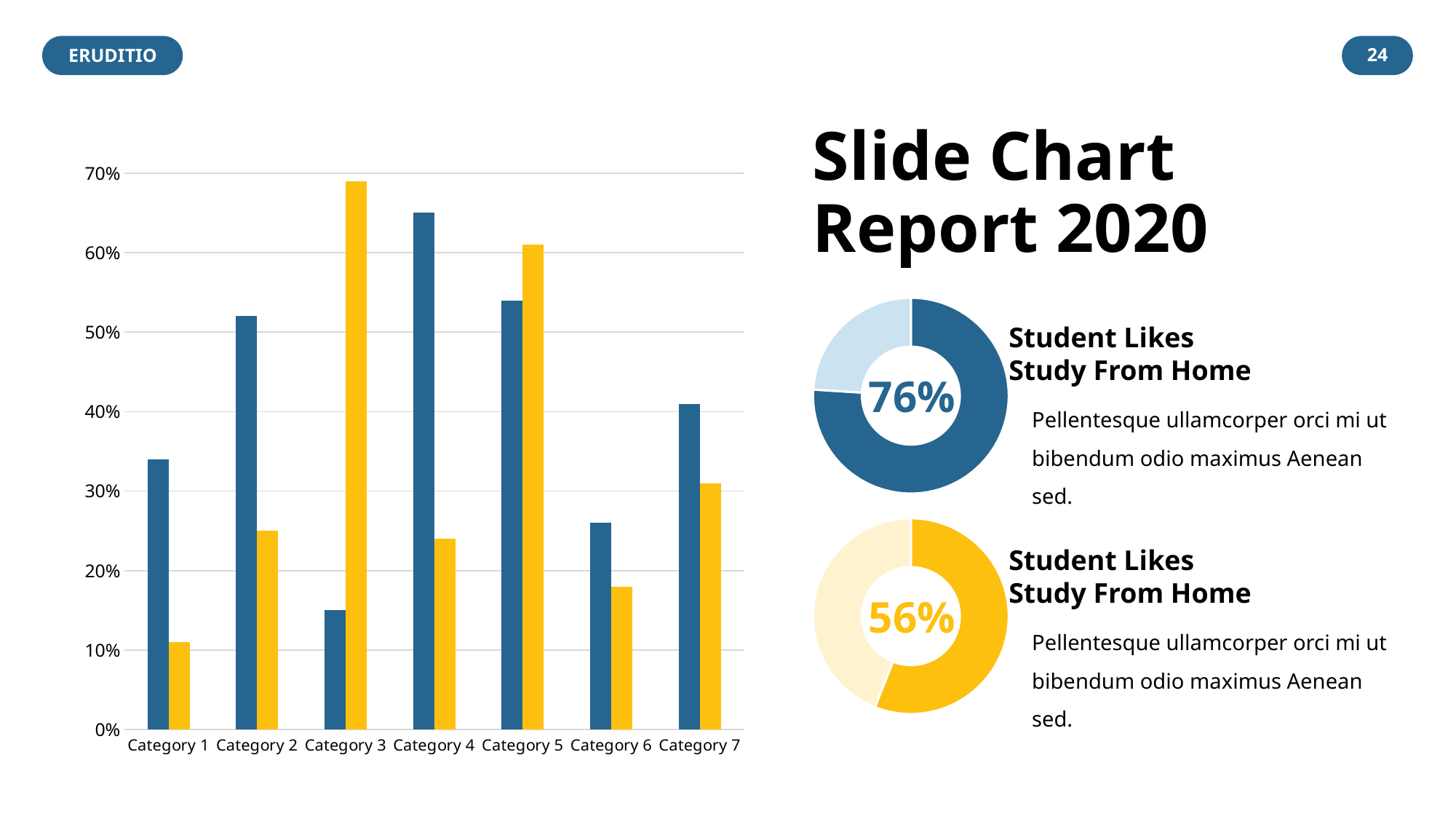
What kind of chart is shown on the left side of the slide? bar chart What percentage is shown in the centre of the yellow donut chart on the right? 56% In the bar chart on the left, which category has the shortest yellow bar? Category 1 In the bar chart on the left, is the blue bar for Category 1 greater or less than 30%? greater In the bar chart on the left, for Category 1, which bar is taller, the blue one or the yellow one? the blue one In the bar chart on the left, which category has the tallest yellow bar? Category 3 In the bar chart on the left, how many categories are shown on the x axis? 7 In the bar chart on the left, which category has the tallest blue bar? Category 4 In the bar chart on the left, which category has the shortest blue bar? Category 3 In the bar chart on the left, for Category 3, which bar is taller, the blue one or the yellow one? the yellow one In the bar chart on the left, is the blue bar for Category 6 greater or less than 30%? less What percentage is shown in the centre of the blue donut chart on the right? 76%